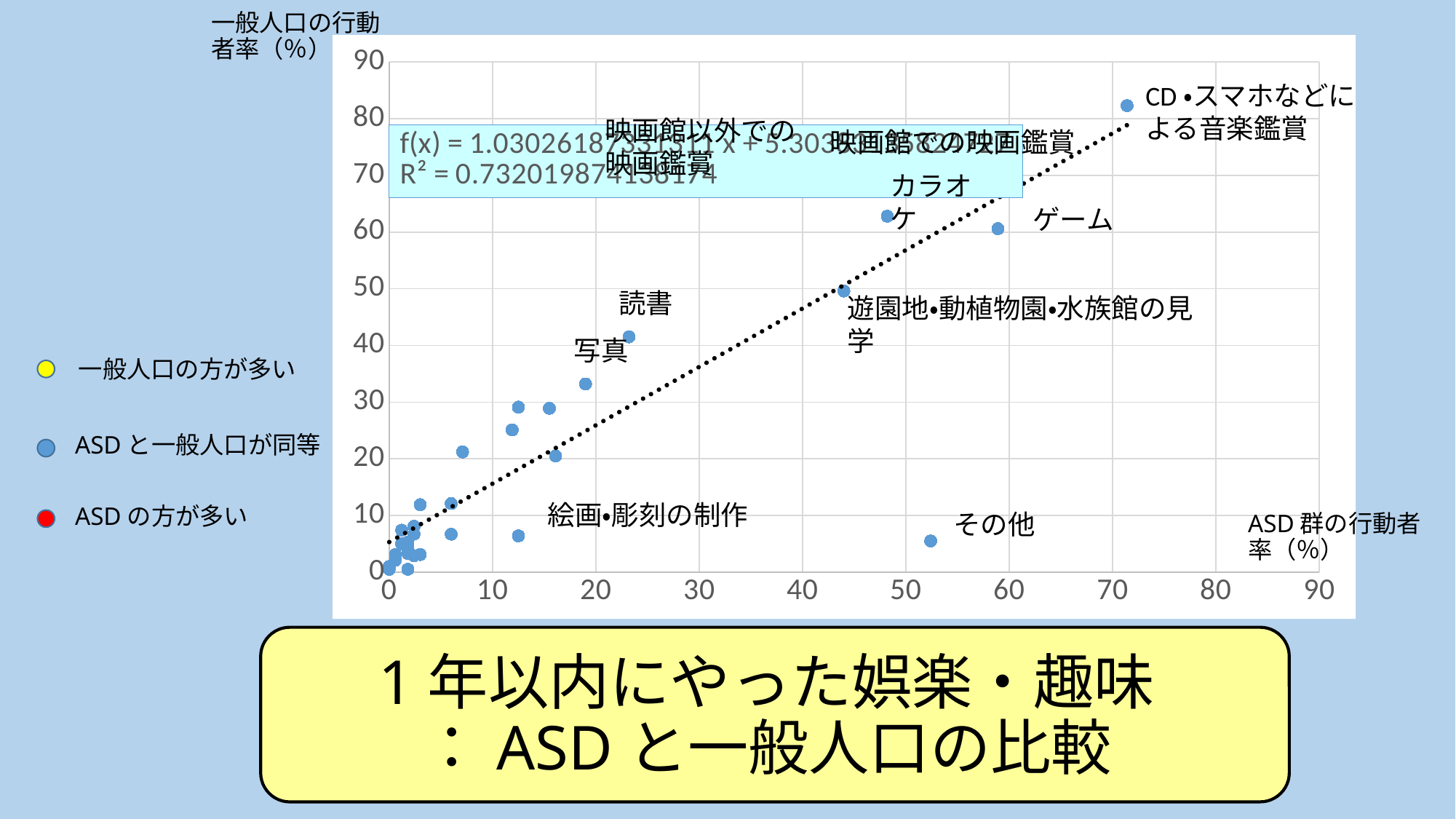
Is the vertical-axis value for CD・スマホなどによる音楽鑑賞 greater or less than 70? greater How many entries does the legend on the left of the chart list? 3 Which labeled activity has the lowest value on the horizontal axis (ASD 群の行動者率)? 絵画・彫刻の制作 What is the label of the horizontal axis of the chart? ASD 群の行動者率（%） What kind of chart is shown on the slide? scatter plot Do the plotted points generally rise or fall as the horizontal-axis value increases? rise Which labeled activity has the highest value on the vertical axis (一般人口の行動者率)? CD・スマホなどによる音楽鑑賞 Is the horizontal-axis value for ゲーム greater or less than 50? greater What is the title of the chart on the slide? １年以内にやった娯楽・趣味：ASD と一般人口の比較 Is the vertical-axis value for その他 greater or less than 10? less Which has the larger vertical-axis value, カラオケ or 写真? カラオケ